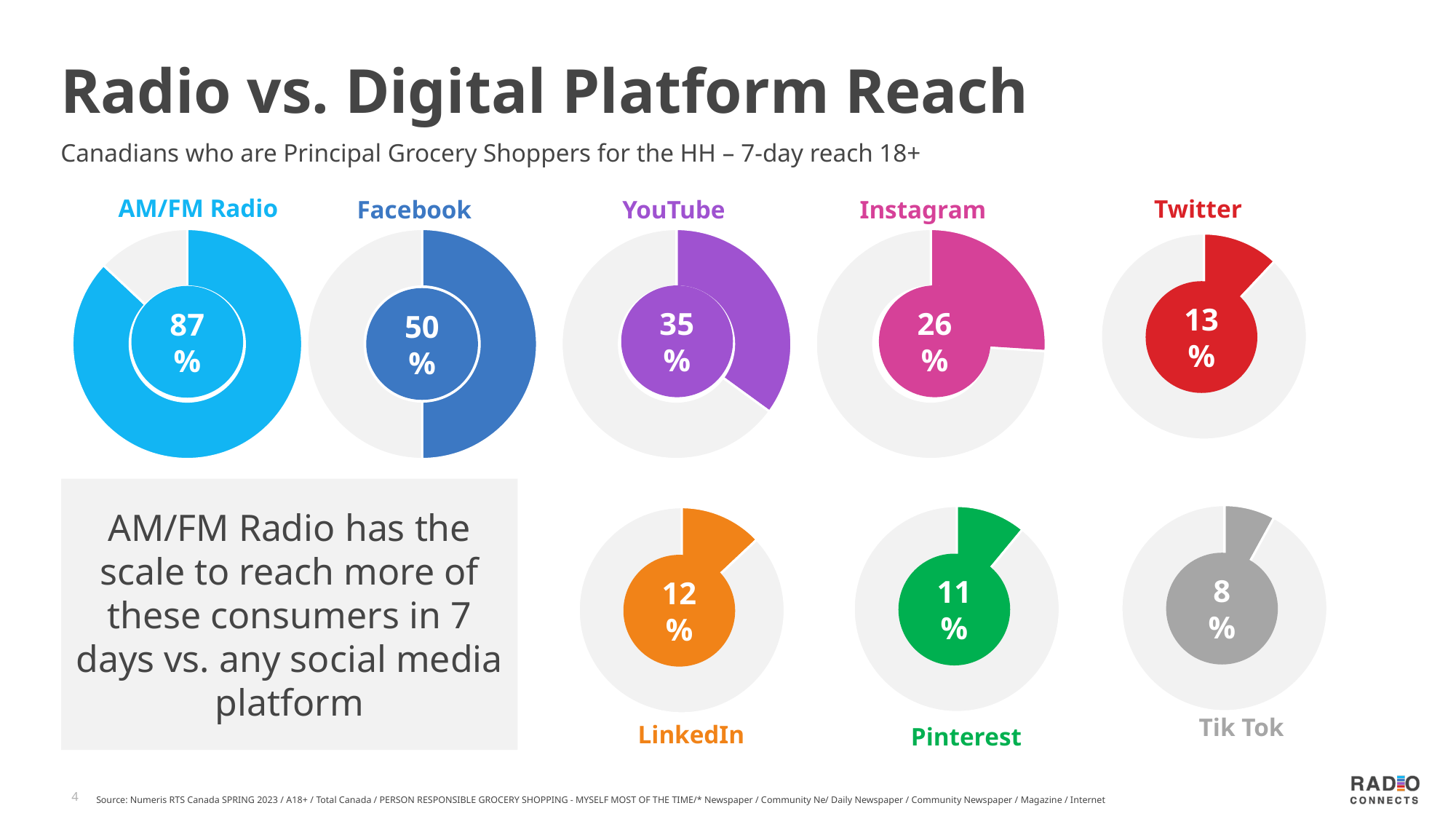
Which has a higher 7-day reach, LinkedIn or Pinterest? LinkedIn What kind of chart is used to show each platform's reach? Doughnut chart How many platforms are shown on the slide? 8 What is the 7-day reach for AM/FM Radio? 87% What is the difference in reach between YouTube and Twitter? 22% What is the 7-day reach for Instagram? 26% Which platform has the lowest 7-day reach? Tik Tok What is the 7-day reach for Facebook? 50% What is the 7-day reach for Tik Tok? 8% What is the difference in reach between AM/FM Radio and Facebook? 37% What colour is the AM/FM Radio chart? Light blue Which platform has the highest 7-day reach? AM/FM Radio